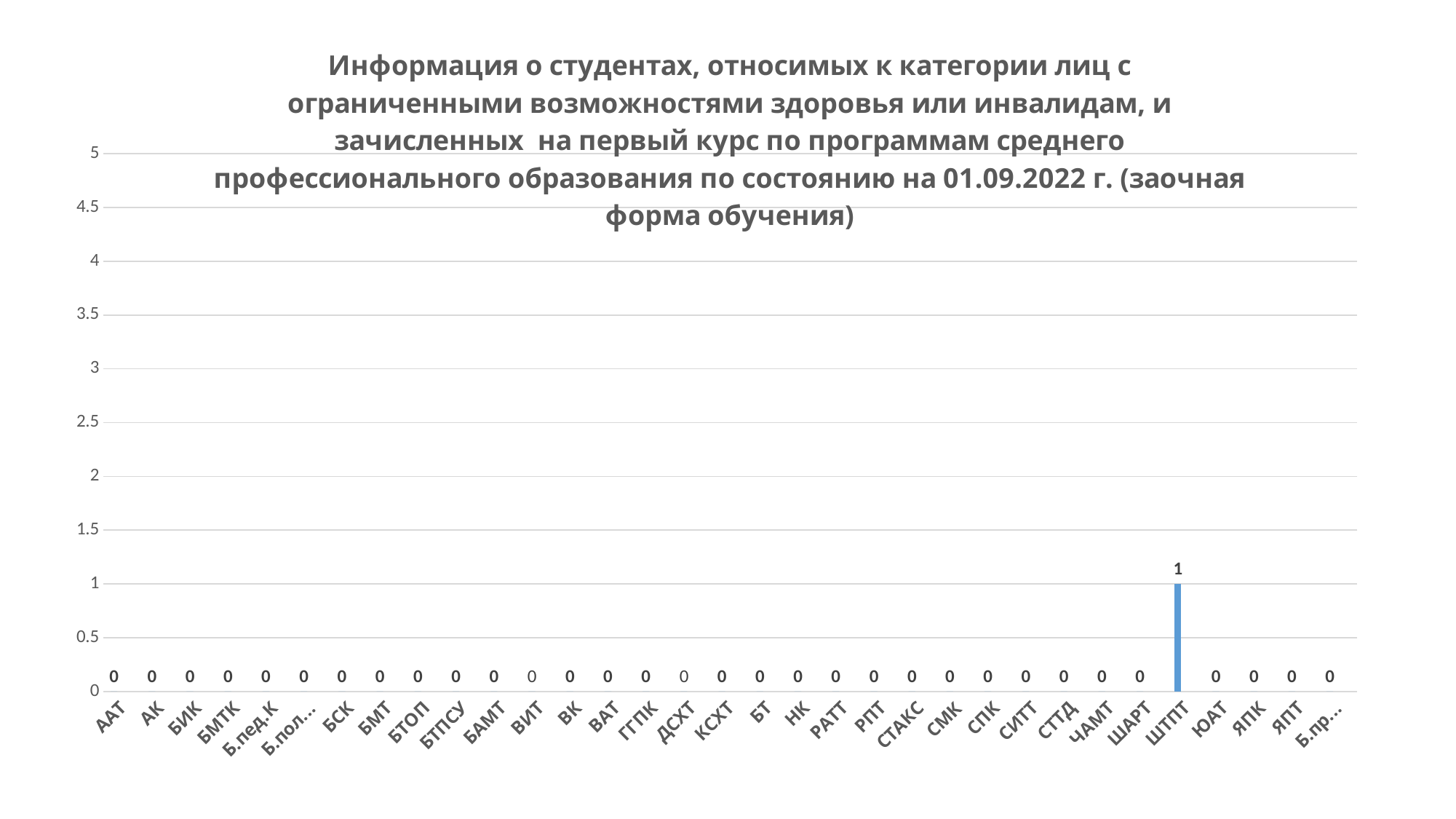
What is the value for ШТПТ? 1 Which category has the highest value? ШТПТ What is the value for СМК? 0 Which is larger, the value for ШТПТ or the value for ЯПК? ШТПТ What is the value for ЮАТ? 0 What is the value for ААТ? 0 What is the total of all values plotted in the chart? 1 What is the highest tick value shown on the y axis? 5 How many categories are shown on the x axis? 33 What kind of chart is shown on the slide? bar chart Is the value for ШТПТ greater or less than 2? less What is the difference between the value for ШТПТ and the value for БСК? 1